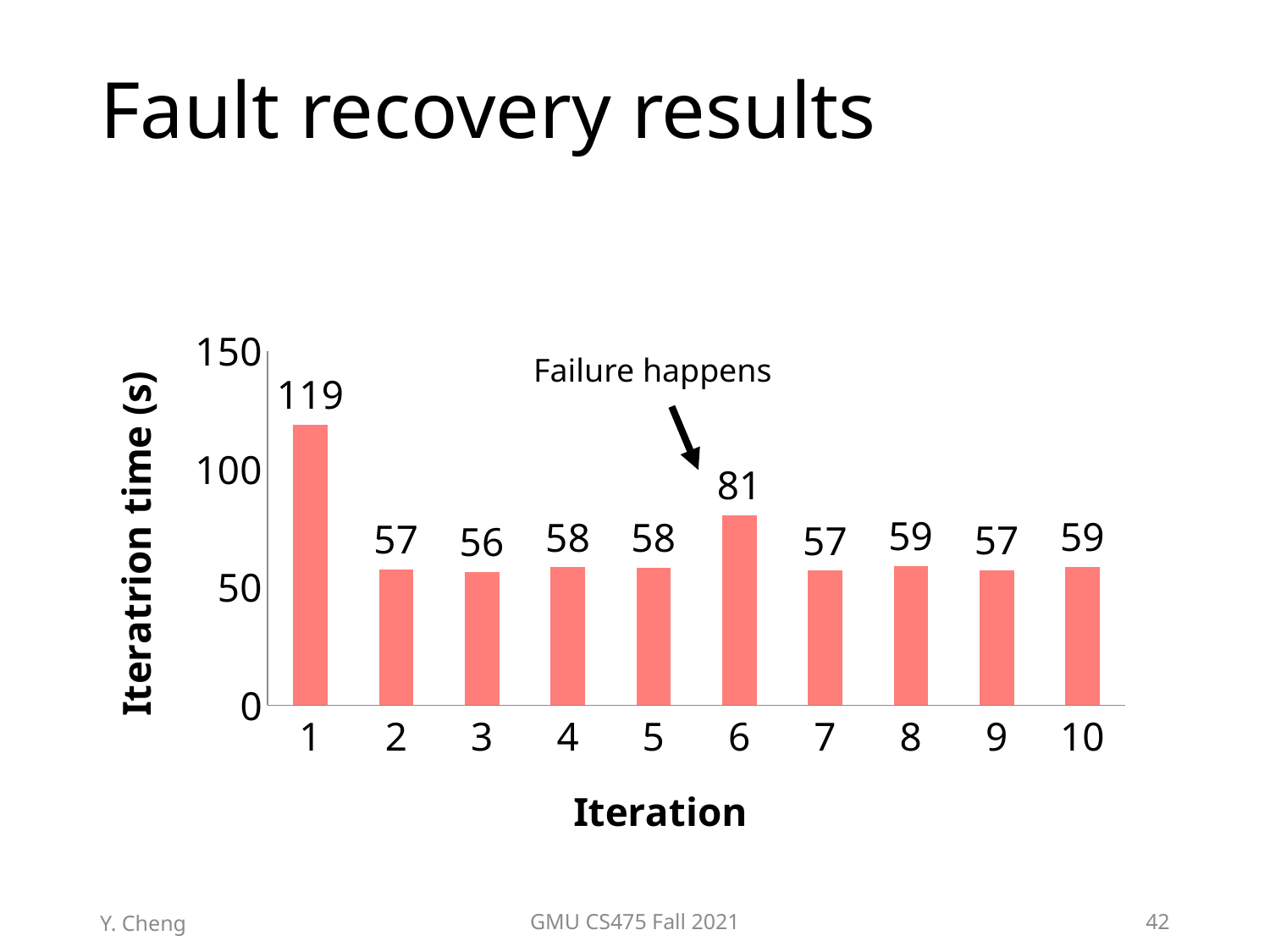
How many iterations are shown on the x axis? 10 Which iteration has the highest iteration time? 1 What is the difference in iteration time between iteration 1 and iteration 6? 38 What is the iteration time for iteration 3? 56 Which has a larger iteration time, iteration 6 or iteration 8? Iteration 6 Which iteration has the lowest iteration time? 3 What is the iteration time for iteration 1? 119 What is the iteration time for iteration 6? 81 At which iteration does the annotation say the failure happens? 6 Is the value for iteration 1 greater or less than 100? greater What kind of chart is shown on the slide? Bar chart What is the difference in iteration time between iteration 6 and iteration 7? 24